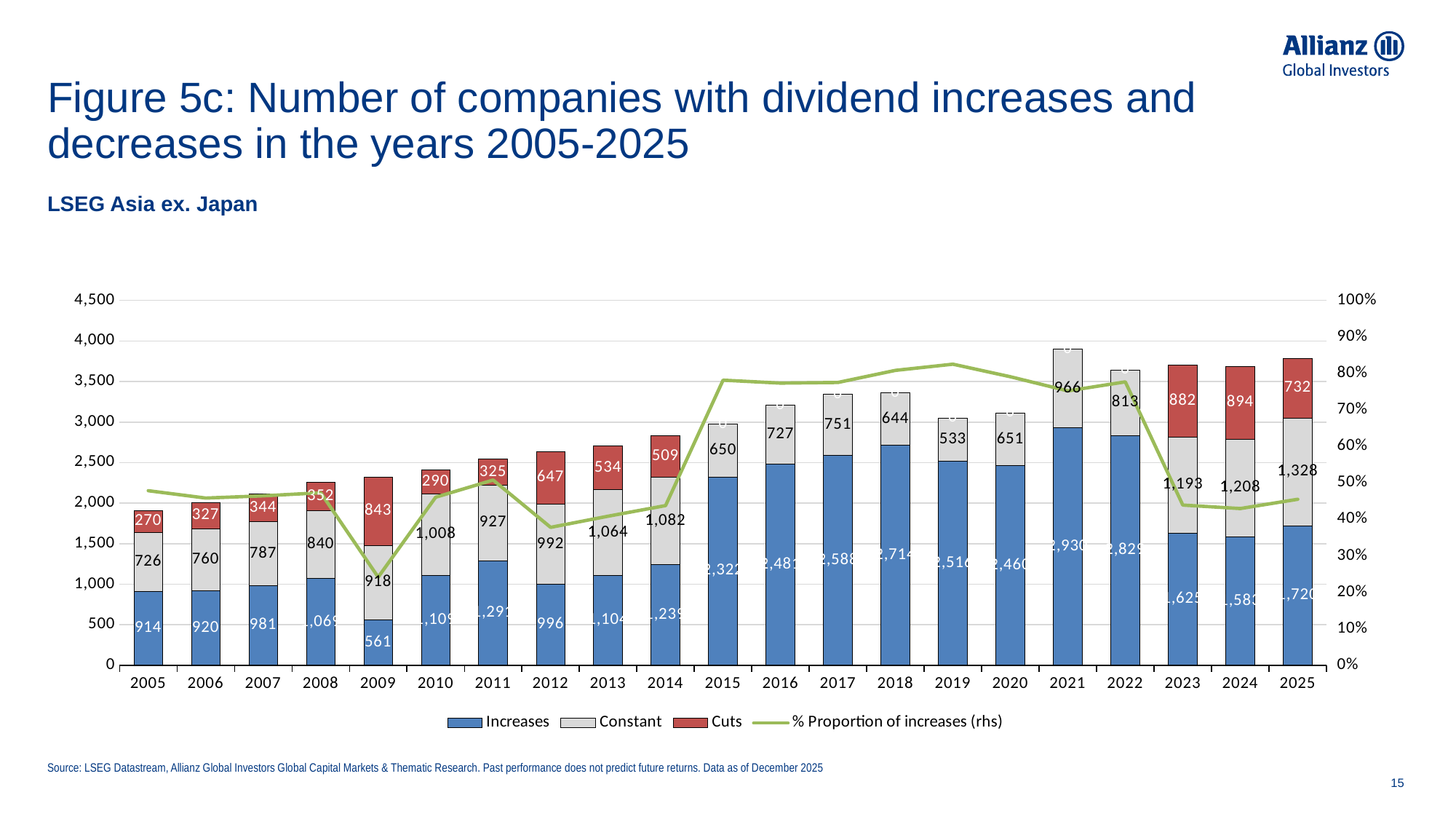
In 2009, which is larger: the Constant value or the Cuts value? Constant What is the total of the stacked bar for 2009? 2,322 How many years are shown on the x axis? 21 How many series does the legend list? 4 What is the value for Cuts in 2005? 270 In which year is the Increases value lowest? 2009 In which year is the Cuts value highest? 2024 What is the value for Cuts in 2009? 843 What is the value for Constant in 2025? 1,328 Is the % Proportion of increases in 2009 greater or less than 30%? less What is the difference between the Cuts value in 2009 and the Cuts value in 2005? 573 What is the value for Increases in 2009? 561